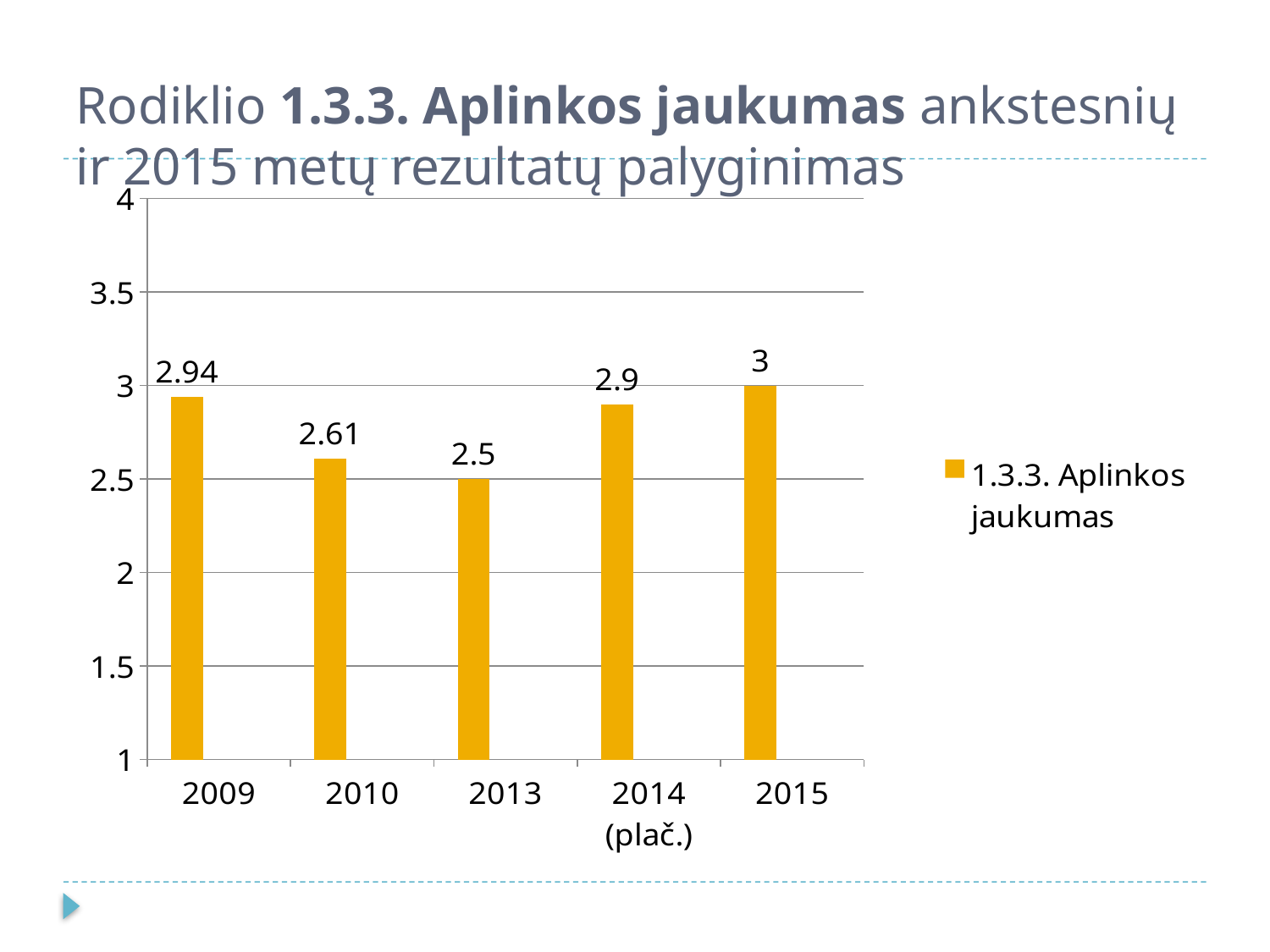
What is the difference between the values for 2015 and 2013? 0.5 What kind of chart is shown on the slide? bar chart What is the difference between the values for 2009 and 2010? 0.33 Is the value for 2010 greater or less than 3? less What is the value for 2013? 2.5 Which year has the highest value? 2015 What series name does the legend show? 1.3.3. Aplinkos jaukumas What is the value for 2009? 2.94 How many years are shown on the x axis? 5 Which year has the lowest value? 2013 What is the value for 2014 (plač.)? 2.9 Which is larger, the value for 2010 or the value for 2014 (plač.)? 2014 (plač.)